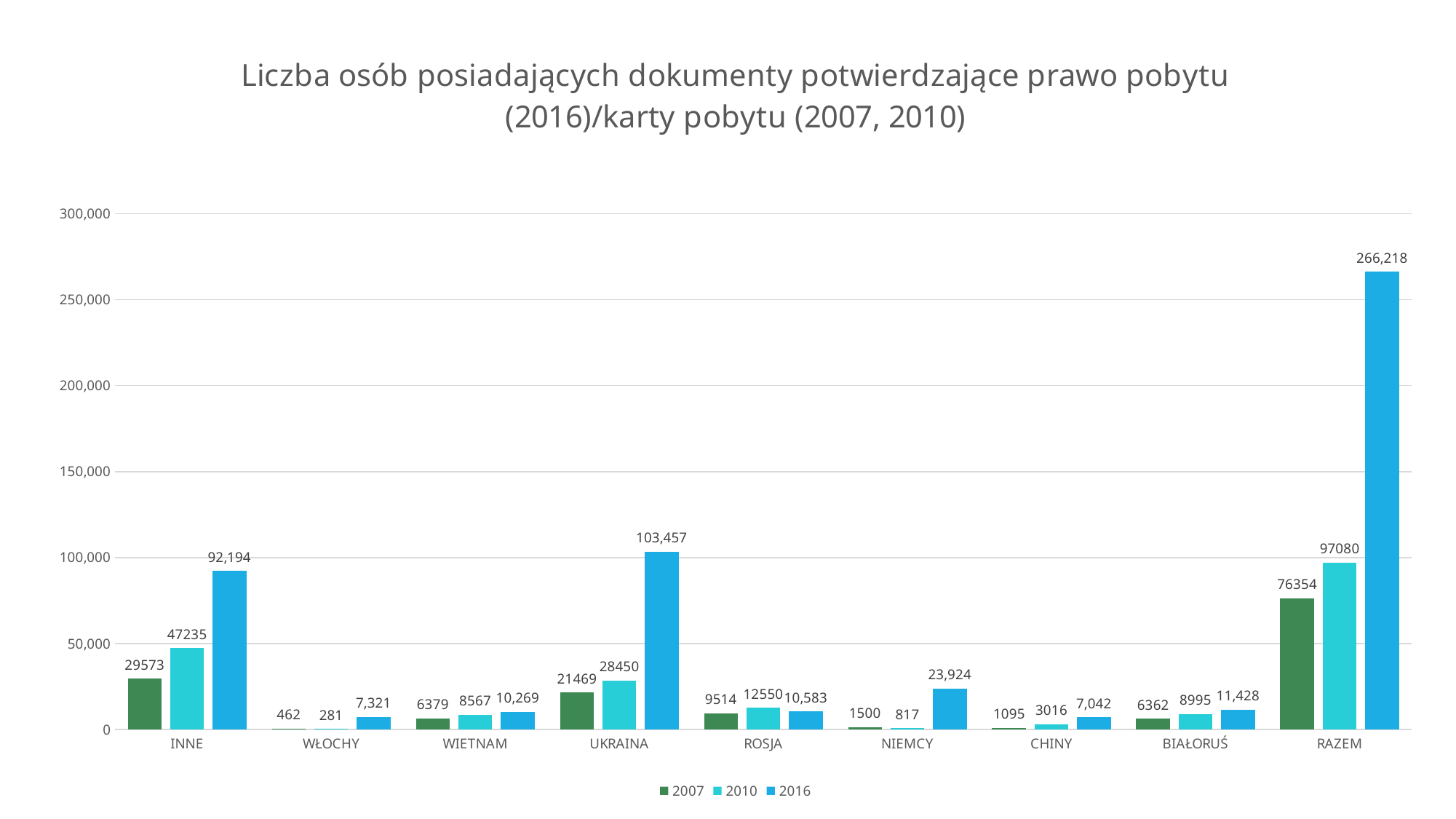
What is the difference between the 2007 and 2010 values for WŁOCHY? 181 What is the 2007 value for INNE? 29573 What is the 2016 value for UKRAINA? 103,457 Do the values for WIETNAM rise or fall from 2007 to 2016? rise How many categories are shown on the x axis? 9 For ROSJA, which series has the larger value, 2010 or 2016? 2010 What is the 2010 value for ROSJA? 12550 Which category has the lowest 2010 value? WŁOCHY What kind of chart is shown on the slide? bar chart Which category has the highest 2016 value? RAZEM How many series does the legend list? 3 Is the 2016 value for RAZEM greater or less than 250,000? greater